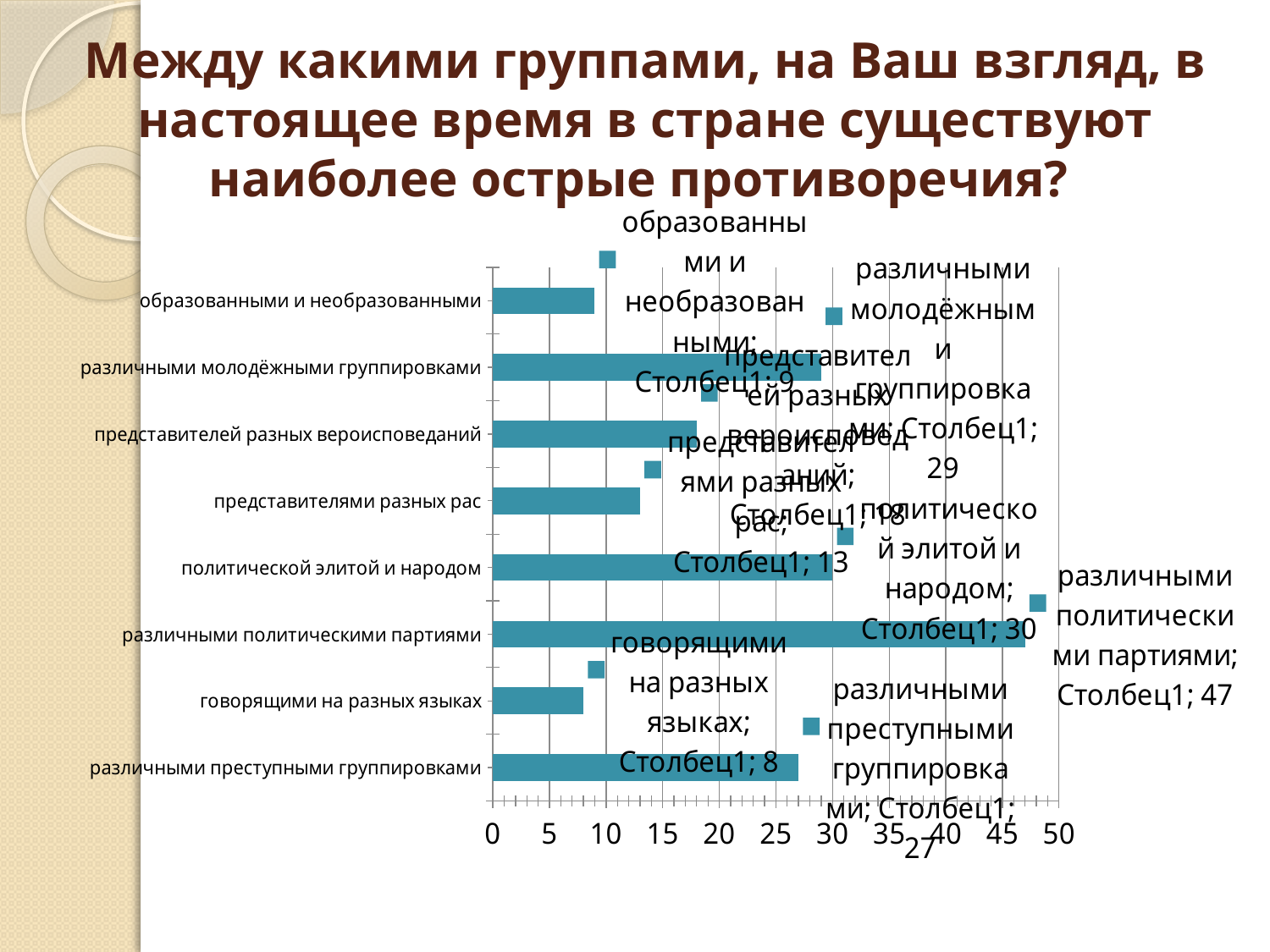
Is the value for 'представителями разных рас' greater or less than 15? less What is the value for 'различными преступными группировками'? 27 What is the difference between the values for 'различными политическими партиями' and 'политической элитой и народом'? 17 What is the value for 'различными политическими партиями'? 47 What type of chart is shown on the slide? bar chart What is the value for 'политической элитой и народом'? 30 How many categories are plotted in the chart? 8 What is the value for 'говорящими на разных языках'? 8 Which is larger: the value for 'различными молодёжными группировками' or for 'представителей разных вероисповеданий'? различными молодёжными группировками Which category has the highest value? различными политическими партиями What is the name of the data series shown in the data labels? Столбец1 Which category has the lowest value? говорящими на разных языках